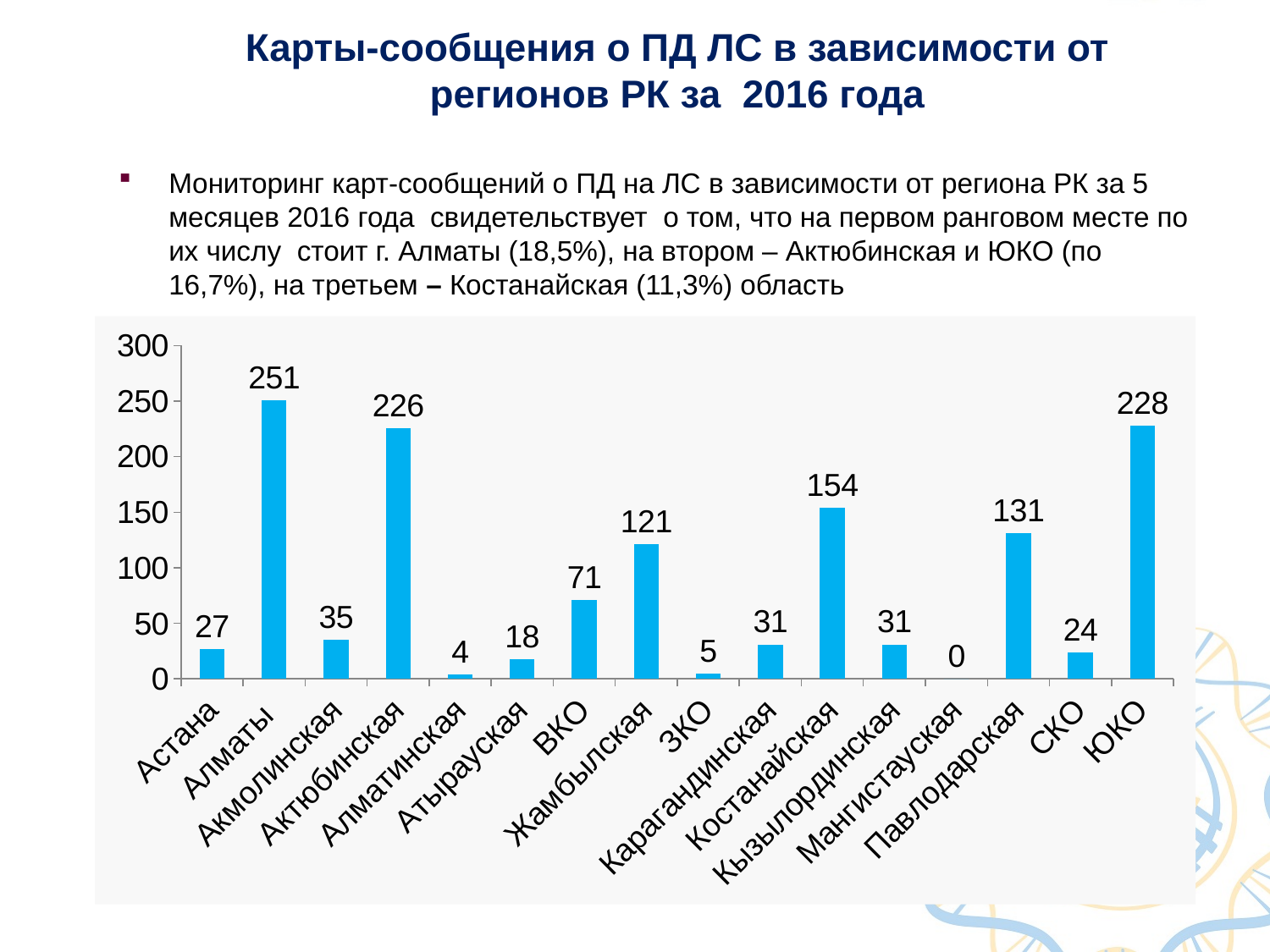
Is the value for Жамбылская greater or less than 100? greater How many regions are shown on the x axis? 16 What is the value for ЮКО? 228 What is the difference between the values for Алматы and ЮКО? 23 What is the value for Костанайская? 154 Which is larger, the value for Костанайская or the value for Павлодарская? Костанайская What is the difference between the values for ВКО and Атырауская? 53 Which region has the highest value? Алматы What is the value for Мангистауская? 0 What is the value for Алматы? 251 Which region has the lowest value? Мангистауская What kind of chart is shown on the slide? bar chart